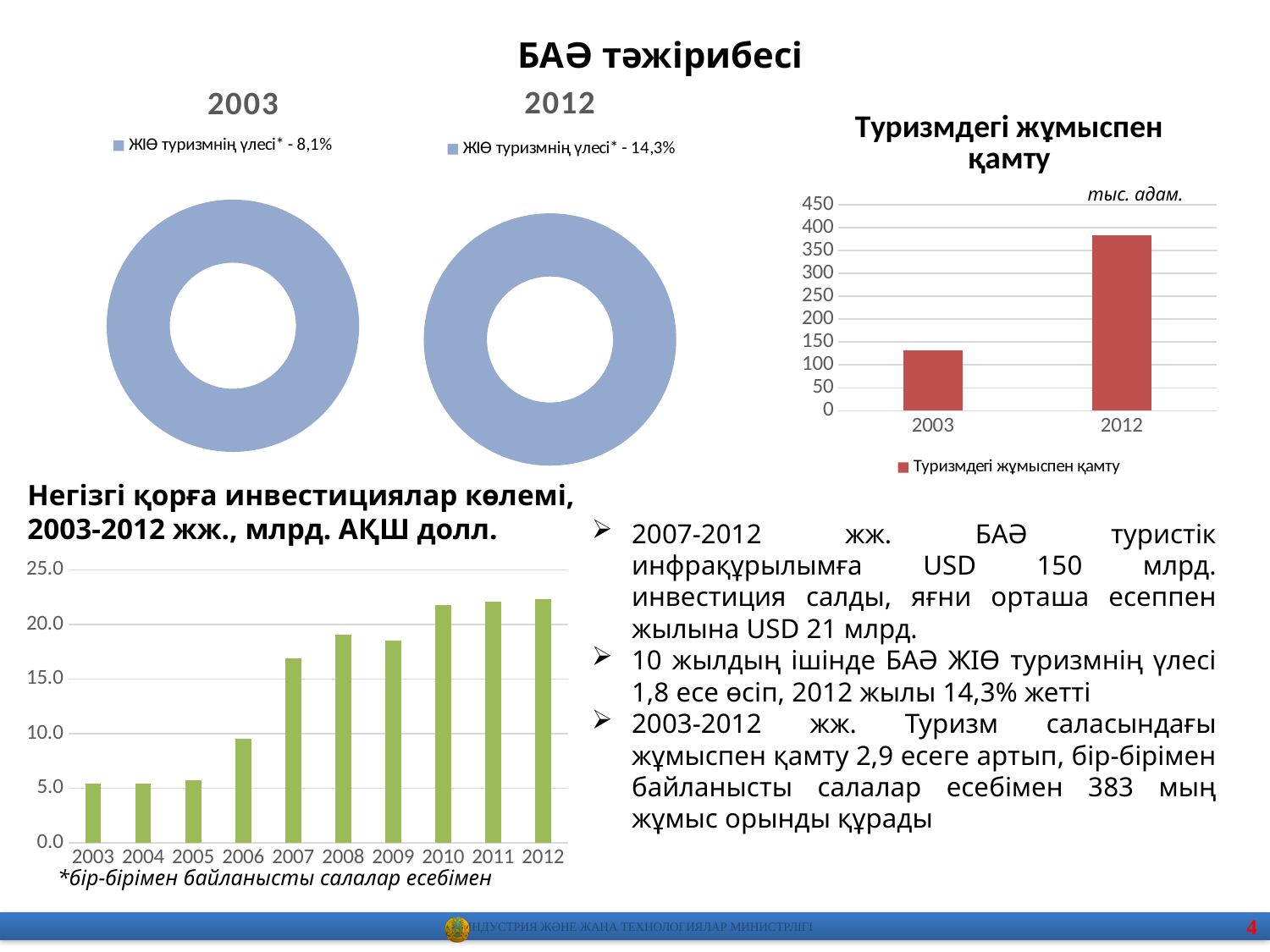
In the 'Негізгі қорға инвестициялар көлемі' chart, which year has the lowest value? 2003 and 2004 (tied) In the 'Туризмдегі жұмыспен қамту' chart, is the value for 2012 greater or less than 350? greater In the 'Туризмдегі жұмыспен қамту' chart, is the value for 2003 greater or less than 150? less What unit is indicated on the 'Туризмдегі жұмыспен қамту' chart? тыс. адам. How many categories are shown on the x axis of the 'Туризмдегі жұмыспен қамту' chart? 2 In the 'Негізгі қорға инвестициялар көлемі' chart, do the values generally rise or fall from 2003 to 2012? rise In the 'Негізгі қорға инвестициялар көлемі' chart, is the value for 2010 greater or less than 20.0? greater In the 'Туризмдегі жұмыспен қамту' chart, which year has the higher value, 2003 or 2012? 2012 What share of GDP does the legend of the 2012 doughnut chart give for tourism? 14,3% What kind of chart is the 'Туризмдегі жұмыспен қамту' chart? bar chart How many years are shown on the x axis of the 'Негізгі қорға инвестициялар көлемі' chart? 10